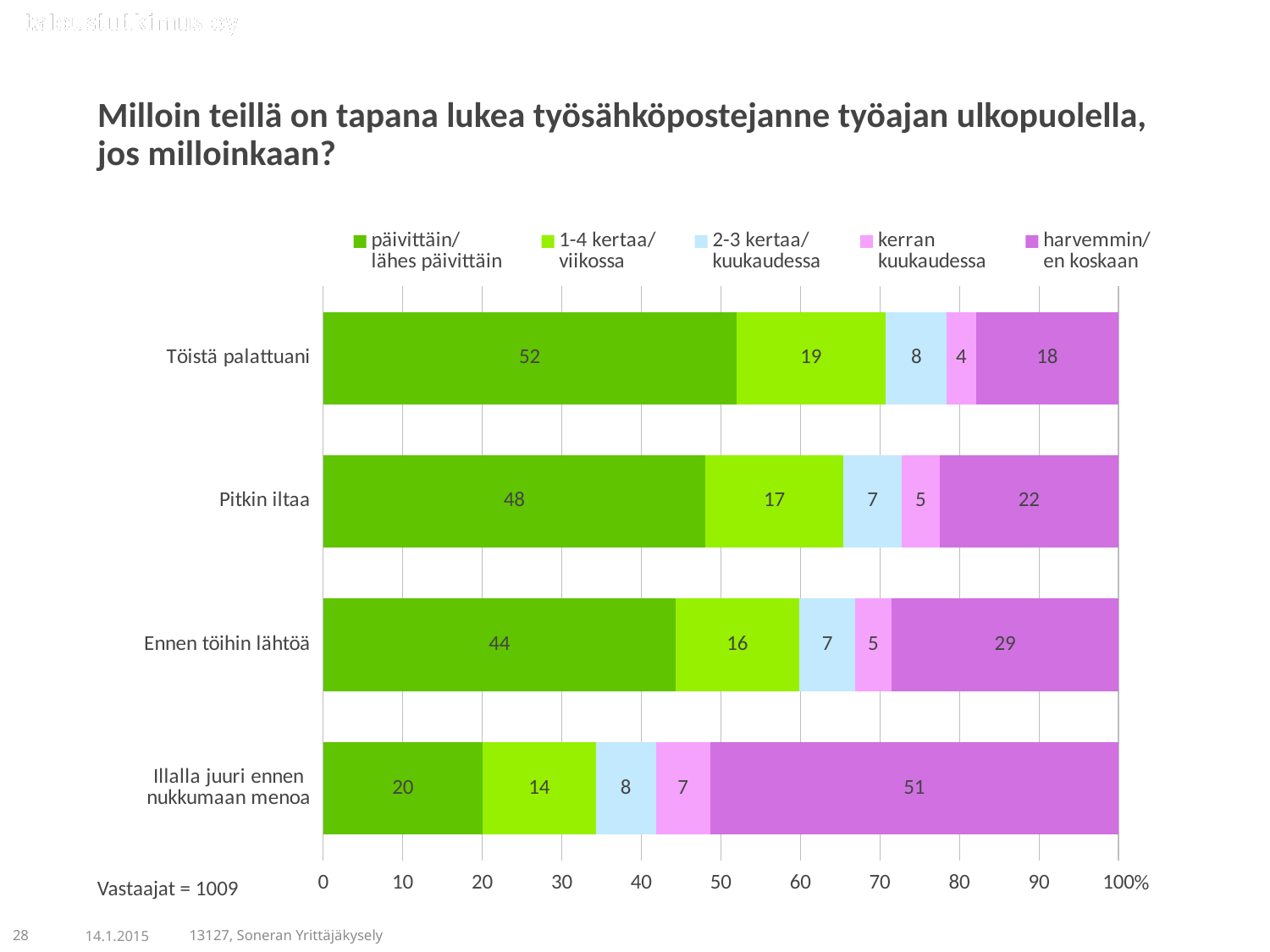
How many series does the legend list? 5 What is the value for "kerran kuukaudessa" in the "Pitkin iltaa" bar? 5 What is the value for "päivittäin/lähes päivittäin" in the "Töistä palattuani" bar? 52 How many categories are shown on the chart? 4 What is the total of the "Illalla juuri ennen nukkumaan menoa" bar? 100 Which category has the highest value for "päivittäin/lähes päivittäin"? Töistä palattuani What kind of chart is shown on the slide? Stacked bar chart Which category has the highest value for "harvemmin/en koskaan"? Illalla juuri ennen nukkumaan menoa Which category has the lowest value for "päivittäin/lähes päivittäin"? Illalla juuri ennen nukkumaan menoa Which has the larger "1-4 kertaa/viikossa" value, "Töistä palattuani" or "Pitkin iltaa"? Töistä palattuani What is the value for "harvemmin/en koskaan" in the "Illalla juuri ennen nukkumaan menoa" bar? 51 What is the difference between the "harvemmin/en koskaan" values for "Ennen töihin lähtöä" and "Pitkin iltaa"? 7